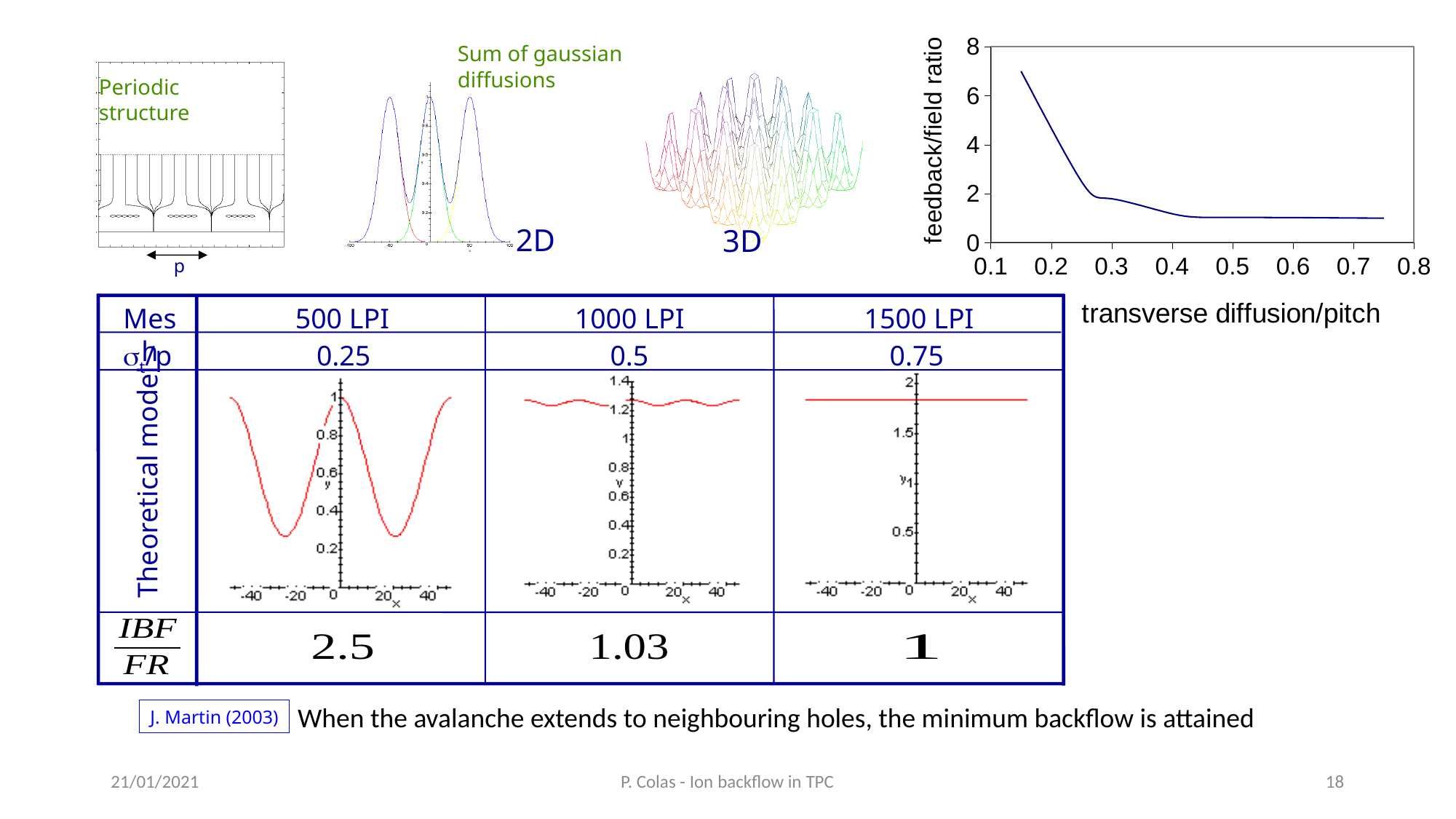
In the theoretical model table, what is the IBF/FR value for 500 LPI? 2.5 In the top-right chart, is the feedback/field ratio at transverse diffusion/pitch 0.3 greater or less than 2? less In the top-right chart, is the feedback/field ratio at transverse diffusion/pitch 0.6 greater or less than 2? less What is the x-axis label of the top-right chart? transverse diffusion/pitch In the theoretical model table, which LPI column has the highest IBF/FR value? 500 LPI In the top-right chart, is the feedback/field ratio higher at the left end or the right end of the x axis? left end In the top-right chart, is the feedback/field ratio at transverse diffusion/pitch 0.15 greater or less than 6? greater In the theoretical model table, what is the IBF/FR value for 1000 LPI? 1.03 What kind of chart is the top-right chart of feedback/field ratio versus transverse diffusion/pitch? line chart What is the y-axis label of the top-right chart? feedback/field ratio In the top-right chart, does the feedback/field ratio rise or fall as transverse diffusion/pitch increases? fall In the theoretical model table, what is the difference between the IBF/FR values for 500 LPI and 1500 LPI? 1.5